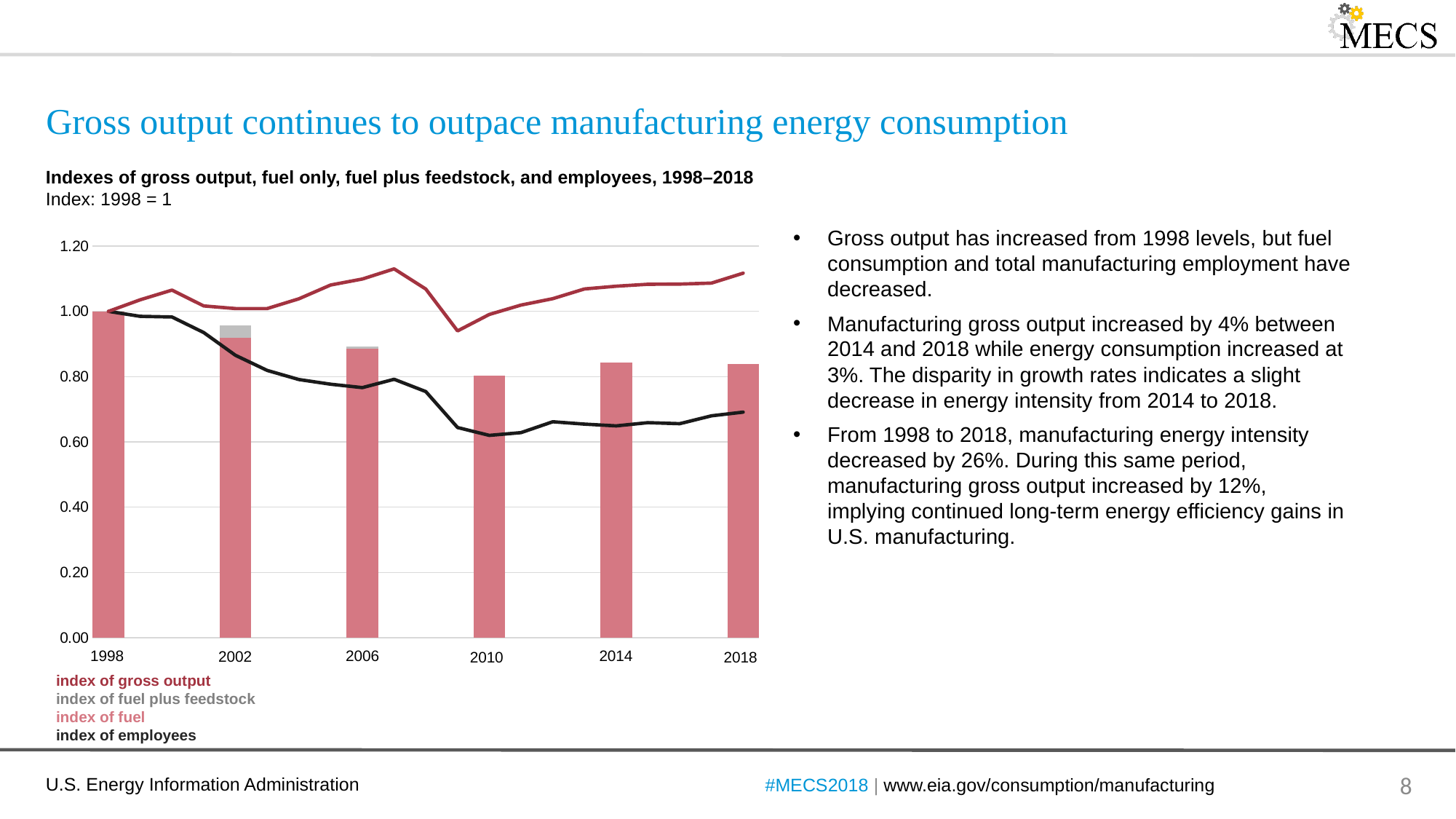
Does the index of employees line rise or fall from 1998 to 2010? fall What is the value of the index of fuel bar for 1998? 1.00 At 2018, which is higher: the index of gross output line or the index of employees line? index of gross output What kind of chart is shown on the slide? A combined bar and line chart Is the index of gross output line at 2018 greater or less than 1.00? greater Is the index of employees line at 2018 greater or less than 0.80? less How many years are shown as bars on the x axis? 6 How many series does the legend list? 4 Which year has the highest index of fuel bar? 1998 Which year has the lowest index of fuel bar? 2010 Is the index of fuel bar for 2010 greater or less than 1.00? less